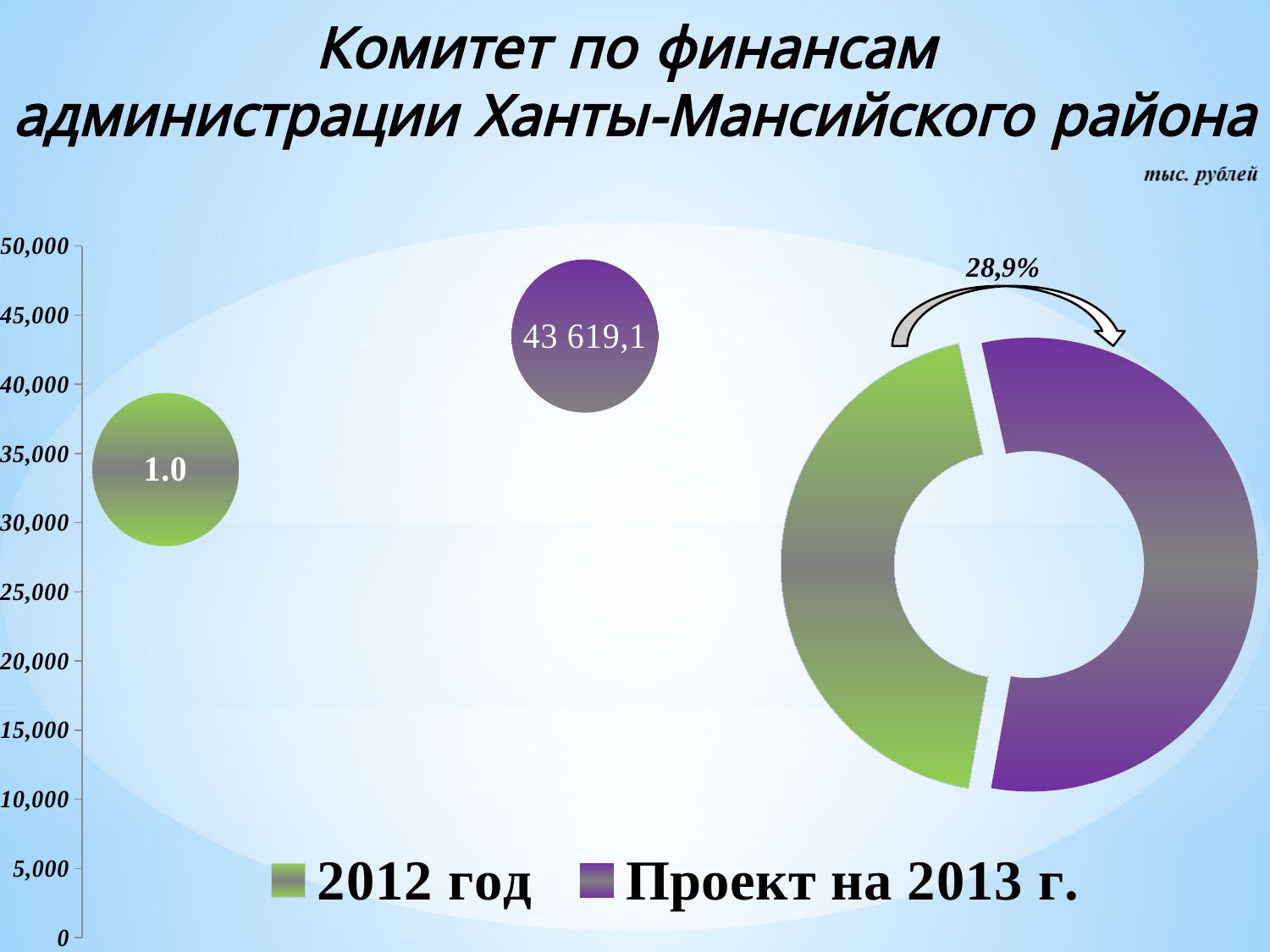
Is the value for "2012 год" in the bubble chart greater or less than 30,000? greater How many slices does the donut chart on the right have? 2 In the donut chart on the right, which slice is larger, the green "2012 год" slice or the purple "Проект на 2013 г." slice? Проект на 2013 г. What value is printed on the purple bubble for "Проект на 2013 г."? 43 619,1 Is the value for "Проект на 2013 г." greater or less than 40,000? greater How many series does the legend list? 2 What are the two legend entries? 2012 год; Проект на 2013 г. Is the value for "2012 год" in the bubble chart greater or less than 40,000? less What percentage is printed above the arrow over the donut chart? 28,9% What unit is stated at the top right of the chart? тыс. рублей What is the highest tick value shown on the vertical axis? 50,000 In the bubble chart on the left, which series has the higher value, "2012 год" or "Проект на 2013 г."? Проект на 2013 г.